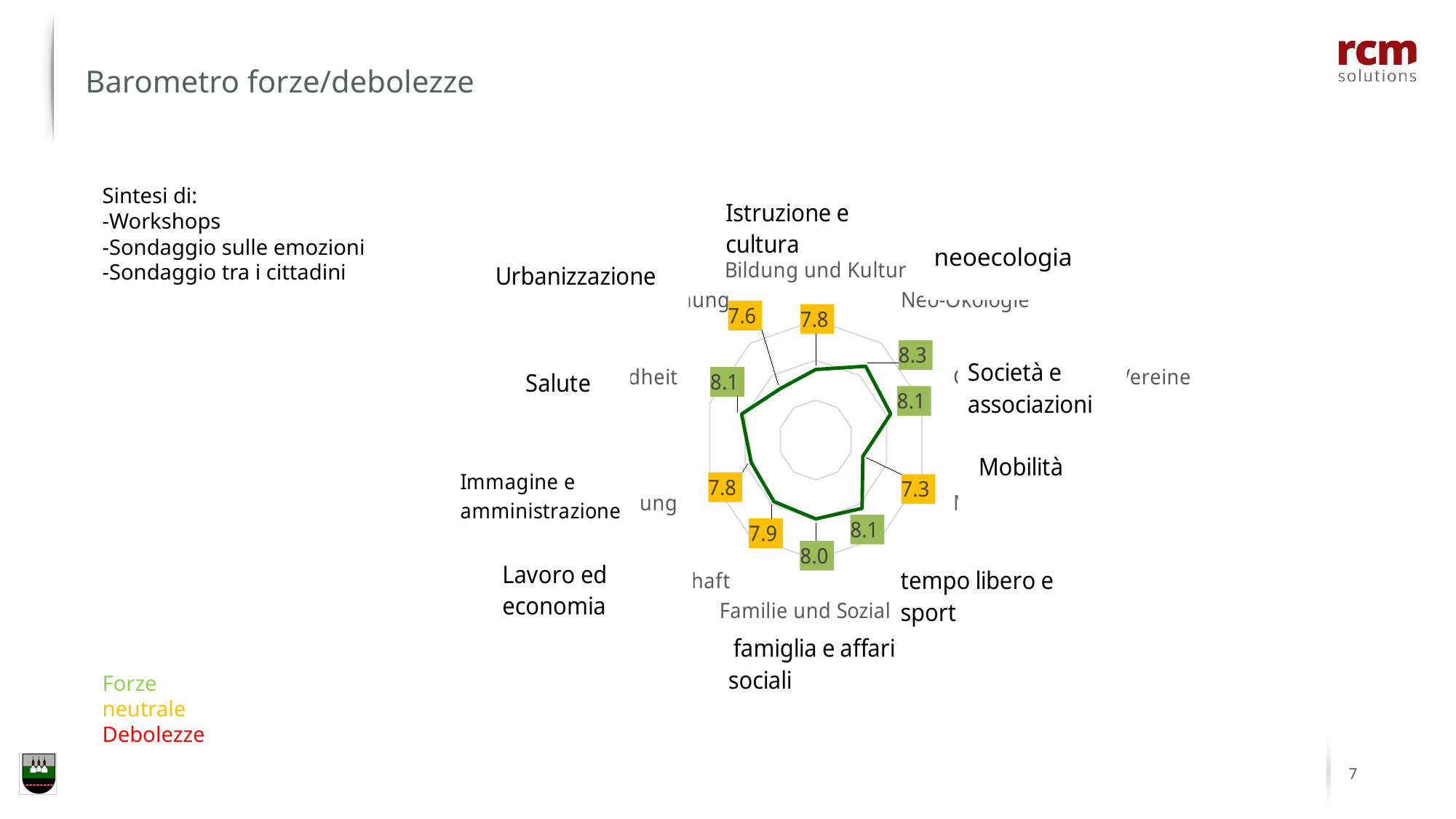
What kind of chart is shown on the slide? radar chart What colour are the data labels for the categories marked as strengths (Forze)? green What is the value for Mobilità? 7.3 What is the value for neoecologia? 8.3 What is the difference between the values for neoecologia and Mobilità? 1.0 Which category has the highest value? neoecologia What is the value for famiglia e affari sociali? 8.0 What is the value for Urbanizzazione? 7.6 What is the value for Lavoro ed economia? 7.9 Which is larger, the value for Salute or the value for Urbanizzazione? Salute How many categories are plotted on the radar chart? 10 Which category has the lowest value? Mobilità